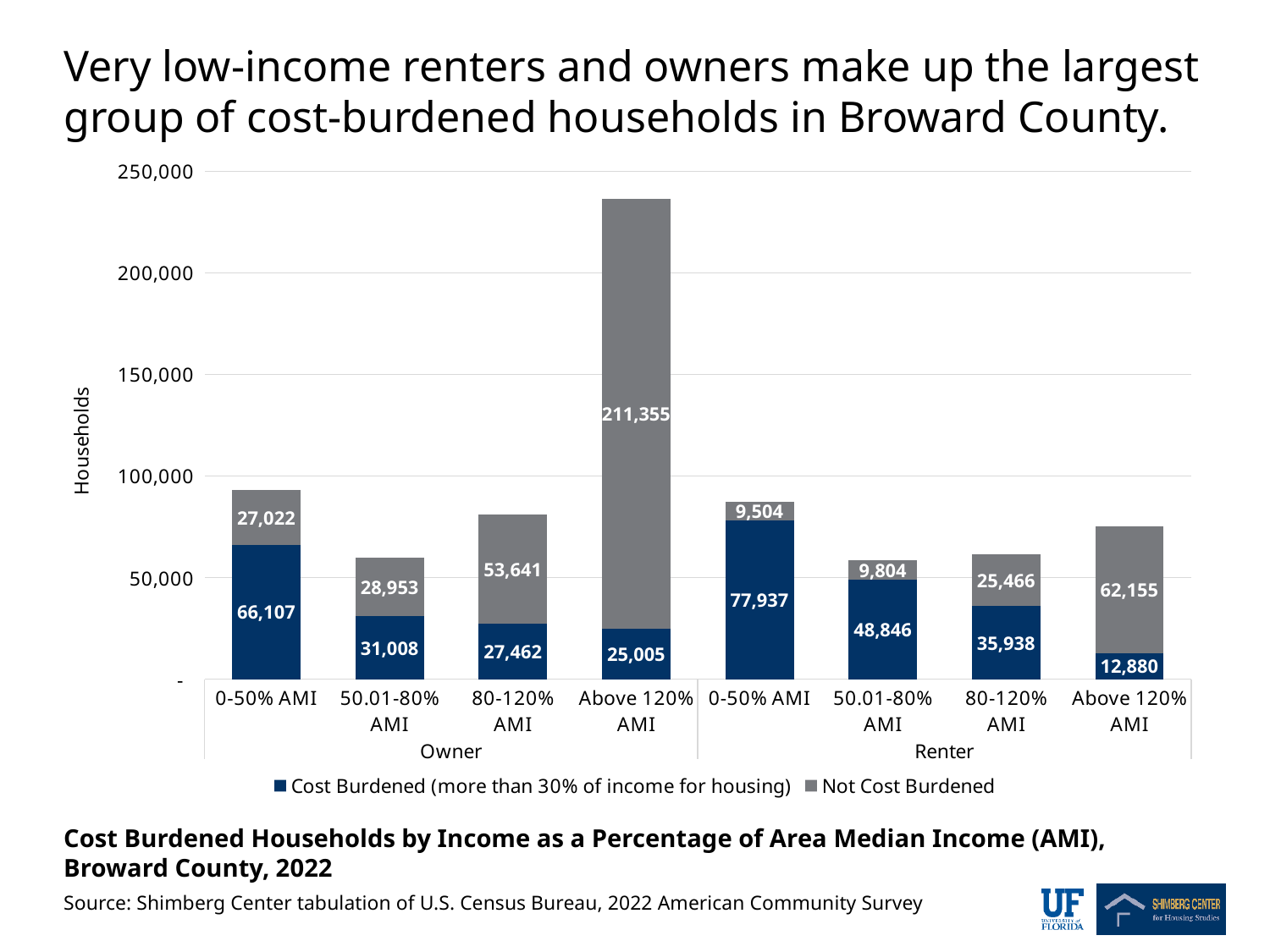
Which group has the lowest number of cost-burdened households? Renter Above 120% AMI How many income-group bars are plotted in total across Owner and Renter? 8 Which is larger: the number of cost-burdened owner households at 80-120% AMI or the number of cost-burdened renter households at 80-120% AMI? Renter 80-120% AMI What is the total number of households in the Owner Above 120% AMI bar? 236,360 What is the number of cost-burdened owner households in the 0-50% AMI group? 66,107 What is the number of cost-burdened renter households in the 50.01-80% AMI group? 48,846 How many series does the legend list? 2 What is the number of not-cost-burdened owner households in the Above 120% AMI group? 211,355 Which group has the highest number of cost-burdened households? Renter 0-50% AMI What type of chart is shown on the slide? Stacked bar chart How many more cost-burdened households are there among 0-50% AMI renters than among 0-50% AMI owners? 11,830 What is the total number of households in the Renter 0-50% AMI bar? 87,441